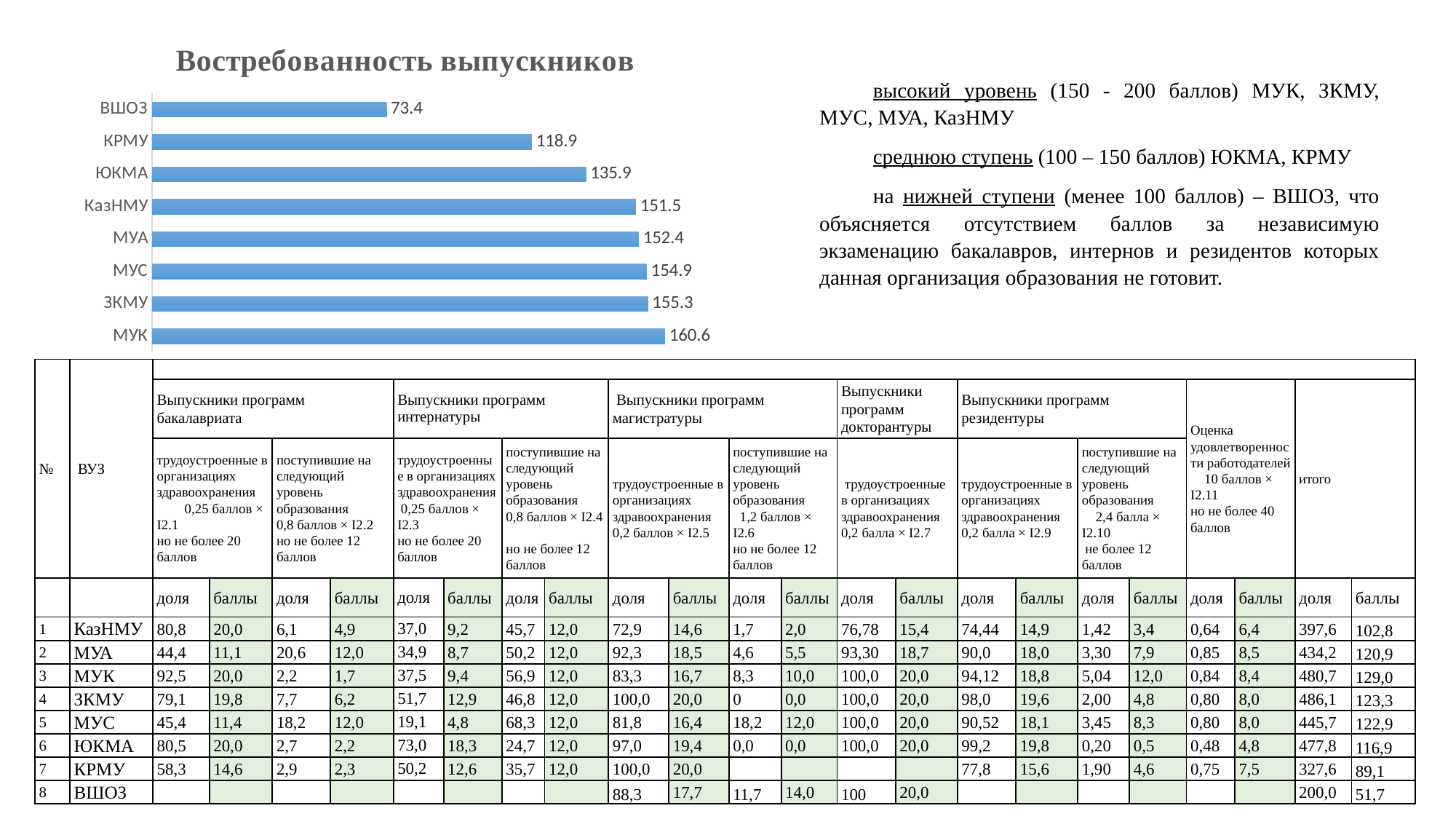
Which category has the highest value in the chart 'Востребованность выпускников'? МУК What is the value for ЮКМА in the chart? 135.9 Which category has the lowest value in the chart? ВШОЗ What is the value for МУС in the chart? 154.9 What is the difference between the values for МУК and ВШОЗ? 87.2 What kind of chart is 'Востребованность выпускников'? Bar chart Which is larger, the value for КРМУ or the value for ЮКМА? ЮКМА What is the value for КРМУ in the chart 'Востребованность выпускников'? 118.9 What is the title of the chart on the slide? Востребованность выпускников Which is larger, the value for МУА or the value for ВШОЗ? МУА What is the difference between the values for ЗКМУ and КазНМУ? 3.8 How many categories are shown in the chart 'Востребованность выпускников'? 8